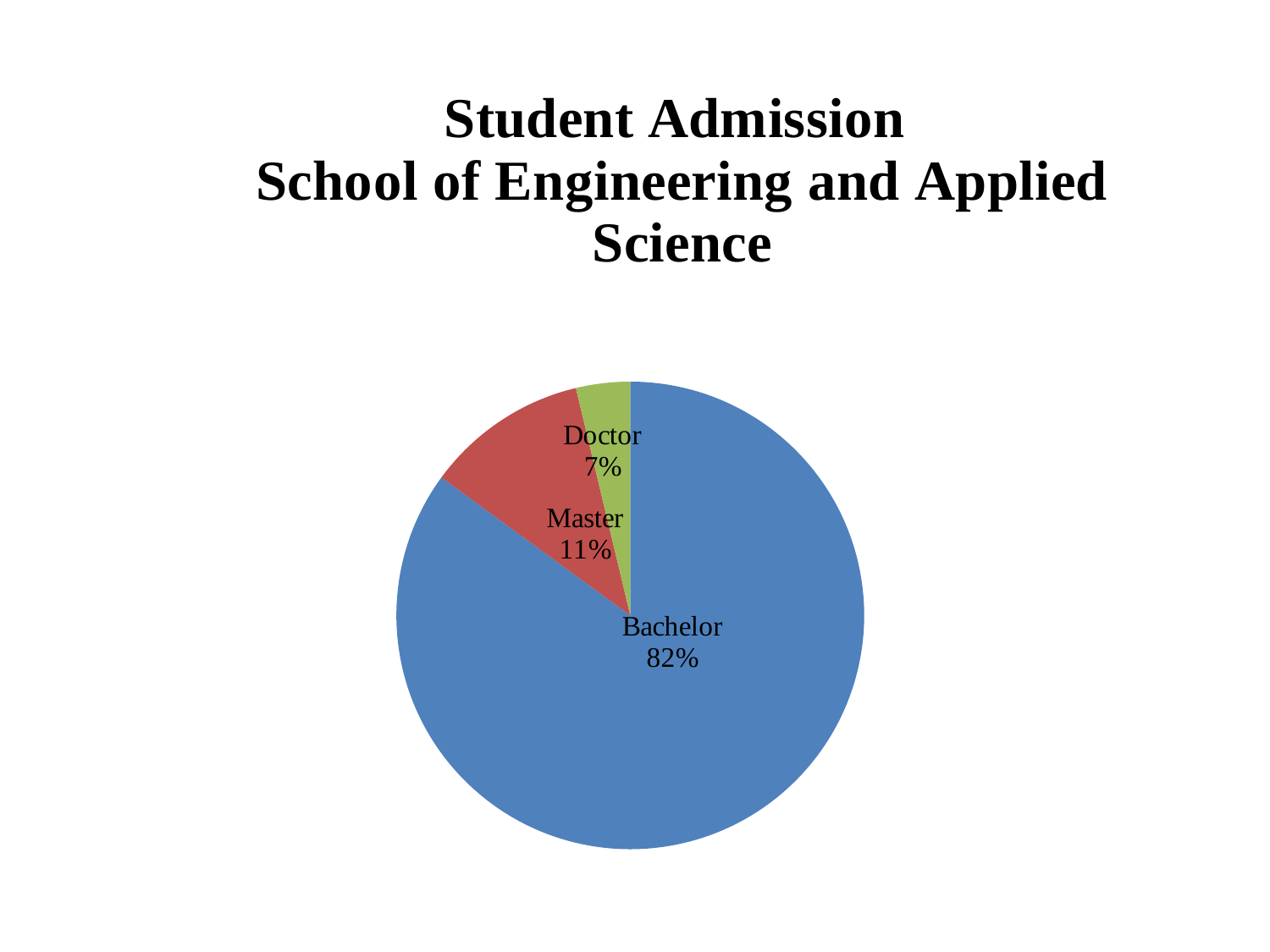
Which slice is larger, Master or Doctor? Master How many slices does the pie chart have? 3 What is the difference in percentage points between the Bachelor and Master slices? 71 What is the title of the slide containing the pie chart? Student Admission School of Engineering and Applied Science Which category has the largest slice of the pie? Bachelor What is the difference in percentage points between the Master and Doctor slices? 4 What kind of chart is shown on the slide? pie chart What share of the pie does Master represent? 11% Which category has the smallest slice of the pie? Doctor What colour is the Bachelor slice of the pie? blue What share of the pie does Bachelor represent? 82% What share of the pie does Doctor represent? 7%